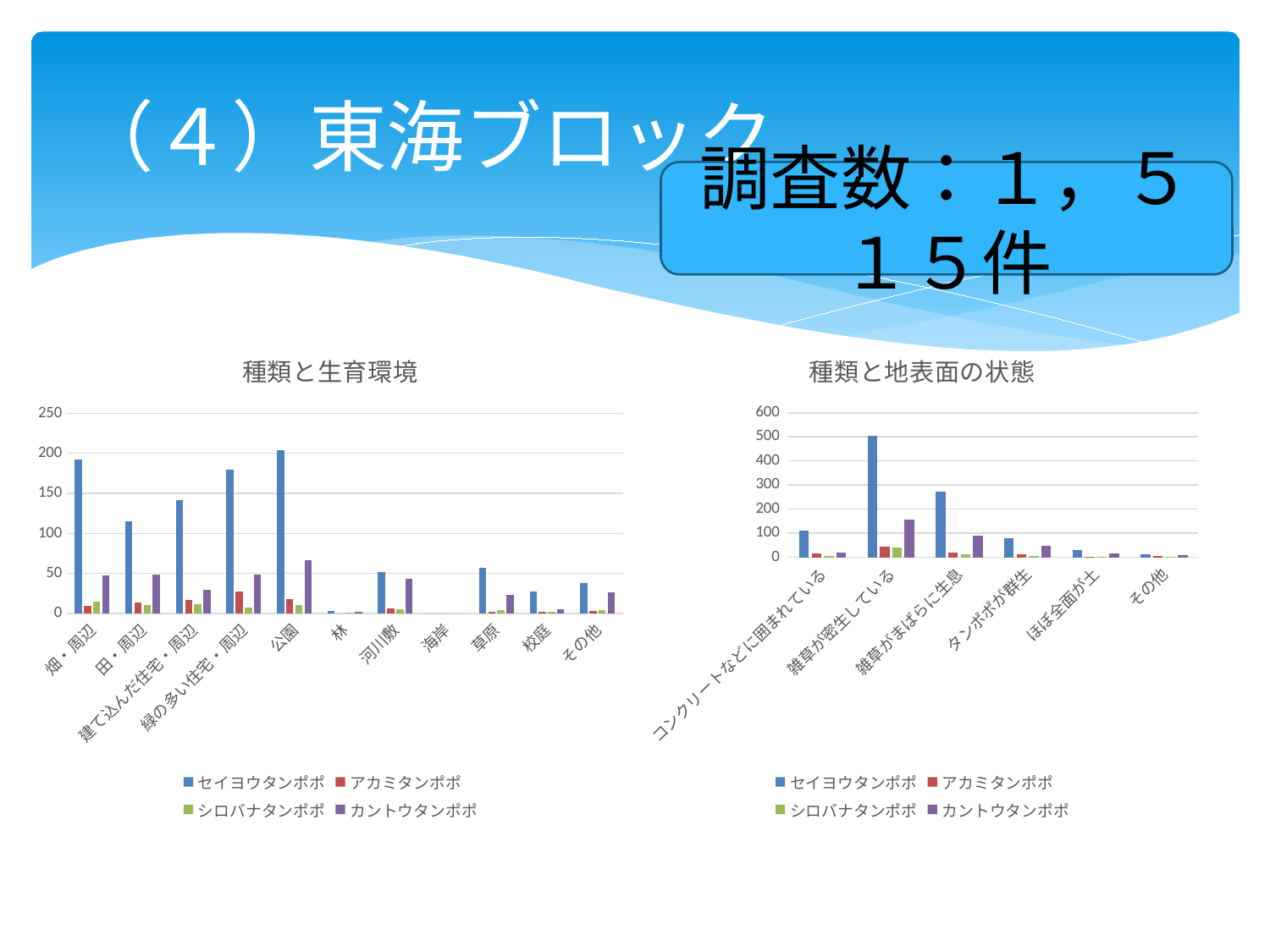
In the chart titled 種類と生育環境, which category has the lowest value for セイヨウタンポポ? 海岸 In the chart titled 種類と地表面の状態, is the value for セイヨウタンポポ at 雑草がまばらに生息 greater or less than 200? greater In the chart titled 種類と生育環境, is the value for セイヨウタンポポ at 畑・周辺 greater or less than 150? greater In the chart titled 種類と地表面の状態, is the value for セイヨウタンポポ at 雑草が密生している greater or less than 400? greater In the chart titled 種類と生育環境, which is larger for セイヨウタンポポ: 建て込んだ住宅・周辺 or 田・周辺? 建て込んだ住宅・周辺 How many categories are shown on the x axis of the chart titled 種類と地表面の状態? 6 In the chart titled 種類と地表面の状態, which category has the highest value for セイヨウタンポポ? 雑草が密生している In the chart titled 種類と生育環境, which series is shown in purple? カントウタンポポ How many series does the legend of the chart titled 種類と地表面の状態 list? 4 What kind of chart is the chart titled 種類と生育環境? bar chart In the chart titled 種類と地表面の状態, which is larger for カントウタンポポ: 雑草が密生している or 雑草がまばらに生息? 雑草が密生している How many categories are shown on the x axis of the chart titled 種類と生育環境? 11